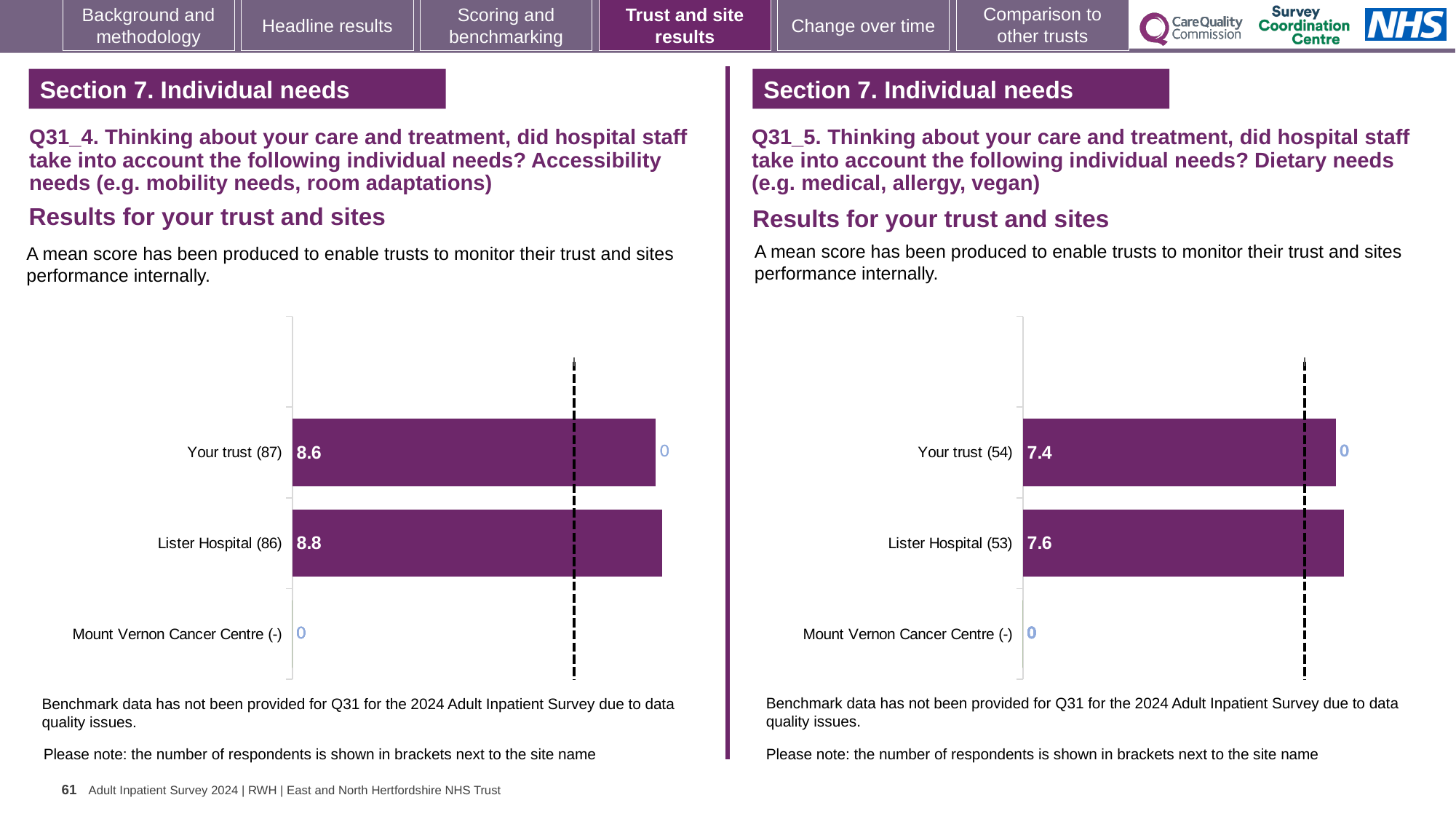
In the right chart (Q31_5, dietary needs), what is the mean score for Your trust? 7.4 In the left chart (Q31_4, accessibility needs), what is the mean score for Lister Hospital? 8.8 In the right chart (Q31_5, dietary needs), what is the mean score for Lister Hospital? 7.6 In the left chart (Q31_4, accessibility needs), what is the mean score for Your trust? 8.6 In the right chart (Q31_5, dietary needs), which has the higher score, Your trust or Lister Hospital? Lister Hospital In the right chart (Q31_5, dietary needs), what is the difference between the Lister Hospital score and the Your trust score? 0.2 In the left chart (Q31_4, accessibility needs), which has the higher score, Your trust or Lister Hospital? Lister Hospital In the left chart (Q31_4, accessibility needs), what is the difference between the Lister Hospital score and the Your trust score? 0.2 How many categories are listed on the y axis of the right chart (Q31_5, dietary needs)? 3 What kind of chart is used on the left side of the slide (Q31_4)? Bar chart In the right chart (Q31_5, dietary needs), how many respondents are shown in brackets for Your trust? 54 In the left chart (Q31_4, accessibility needs), how many respondents are shown in brackets for Lister Hospital? 86